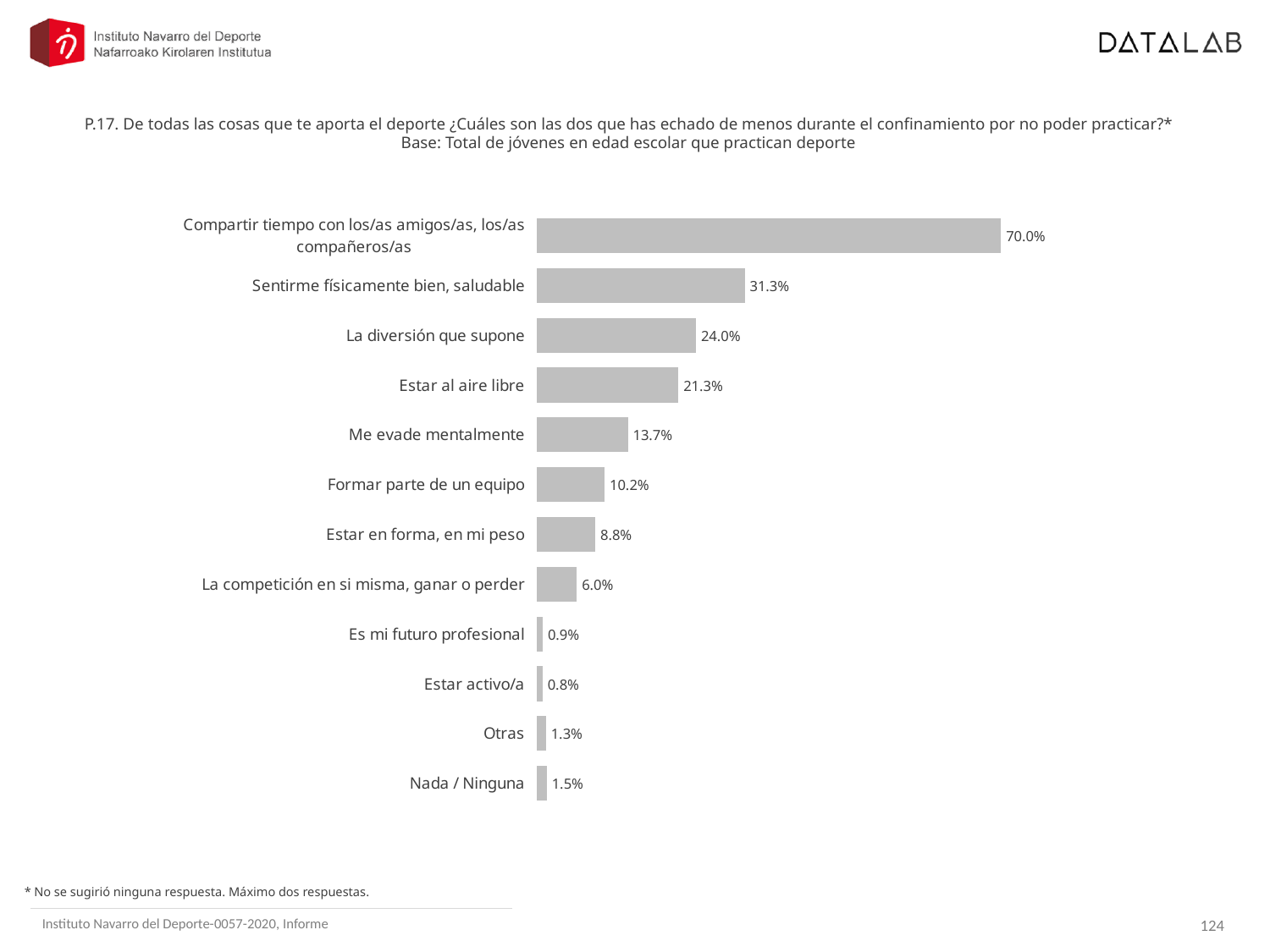
What is the difference between the values for "La diversión que supone" and "Me evade mentalmente"? 10.3% Which is larger, the value for "Estar en forma, en mi peso" or the value for "La competición en si misma, ganar o perder"? Estar en forma, en mi peso What is the value for "Nada / Ninguna"? 1.5% What colour are the bars in the chart? Grey Which category has the lowest value? Estar activo/a Which category has the highest value? Compartir tiempo con los/as amigos/as, los/as compañeros/as What is the difference between the values for "Compartir tiempo con los/as amigos/as, los/as compañeros/as" and "Sentirme físicamente bien, saludable"? 38.7% What is the value for "Formar parte de un equipo"? 10.2% What is the value for "Sentirme físicamente bien, saludable"? 31.3% What kind of chart is shown on the slide? Bar chart How many categories are shown in the chart? 12 What is the value for "Estar al aire libre"? 21.3%